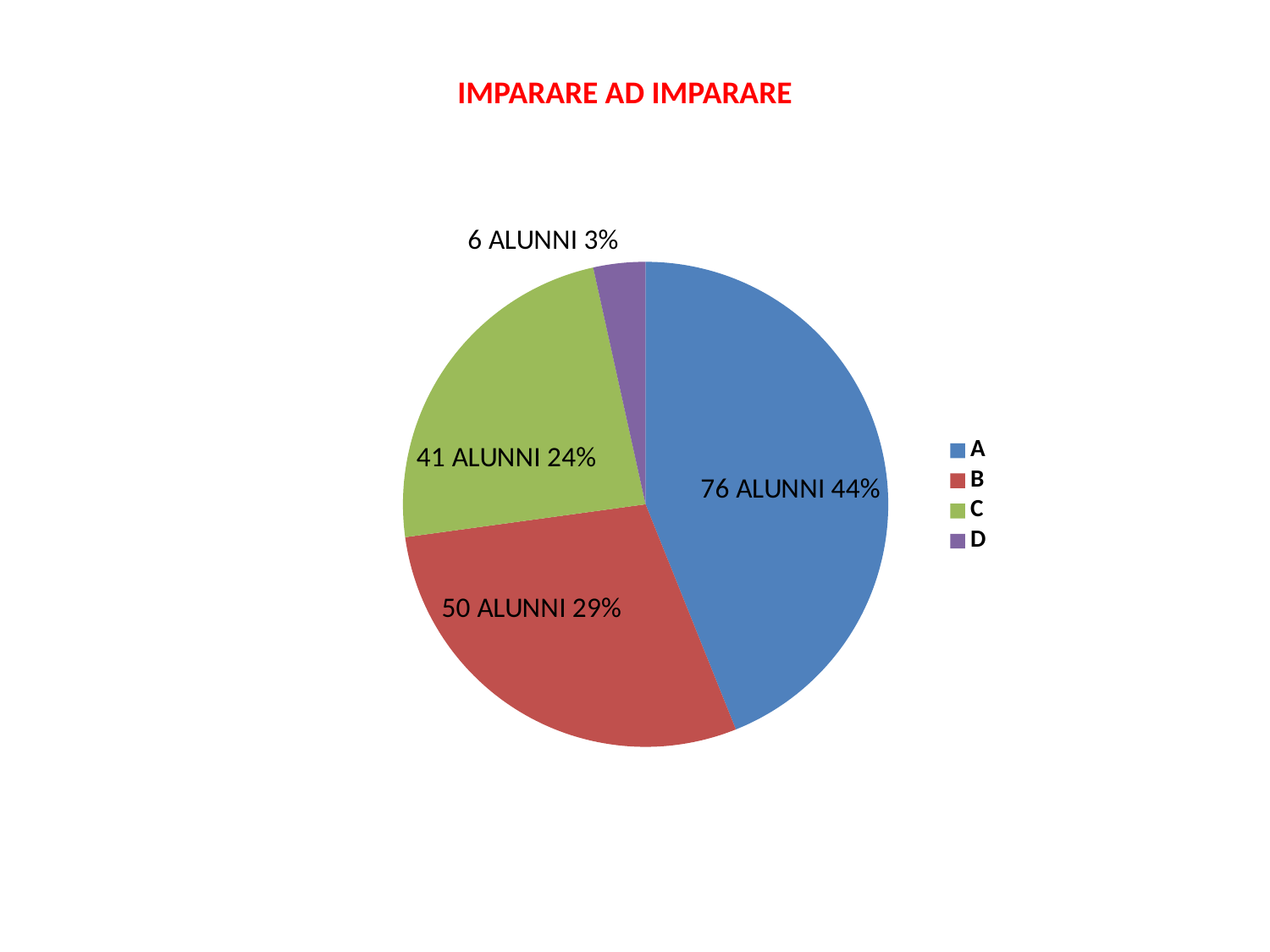
Which category has more alunni, B or C? B What kind of chart is shown on the slide? pie chart Which category has the smallest slice? D What is the title of the chart? IMPARARE AD IMPARARE How many slices does the pie chart have? 4 What percentage share does category C have? 24% What is the difference in number of alunni between category A and category B? 26 What percentage share does category B have? 29% How many alunni are in category A? 76 ALUNNI How many alunni are in category D? 6 ALUNNI Which category has the largest slice? A How many entries does the legend list? 4